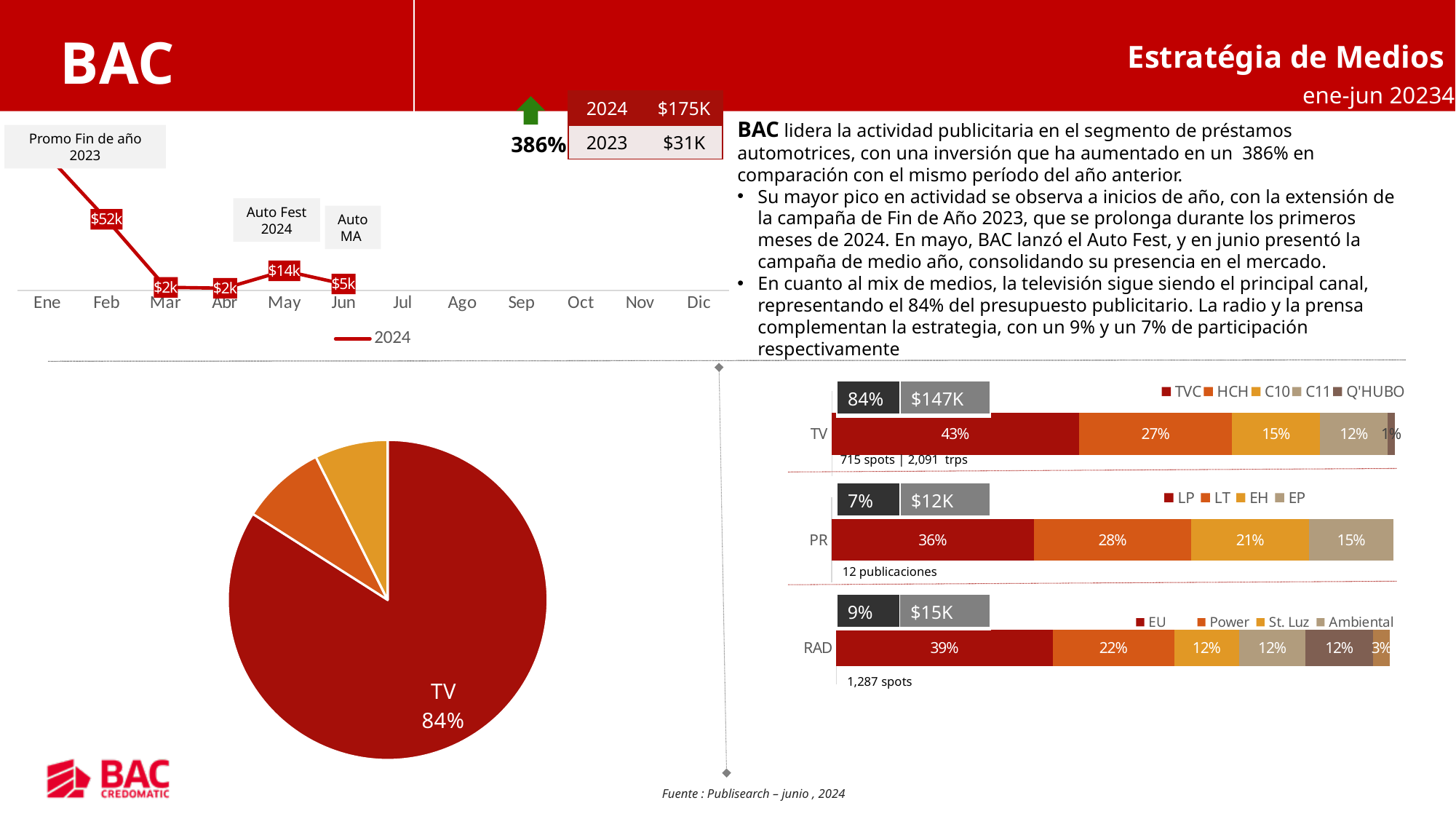
In the line chart at the top left, what is the value for Jun? $5k In the TV stacked bar chart on the right, what is the value for TVC? 43% In the PR stacked bar chart on the right, which segment is the smallest? EP In the line chart at the top left, which is larger, the value for May or the value for Jun? May In the line chart at the top left, what is the difference between the Feb and May values? $38k In the line chart at the top left, what is the value for May? $14k In the pie chart, what share does the TV slice represent? 84% In the line chart at the top left, what series does the legend list? 2024 In the PR stacked bar chart on the right, what is the difference between LP and LT? 8% In the line chart at the top left, what is the value for Feb? $52k In the TV stacked bar chart on the right, how many series does the legend list? 5 In the RAD stacked bar chart on the right, what is the value for EU? 39%